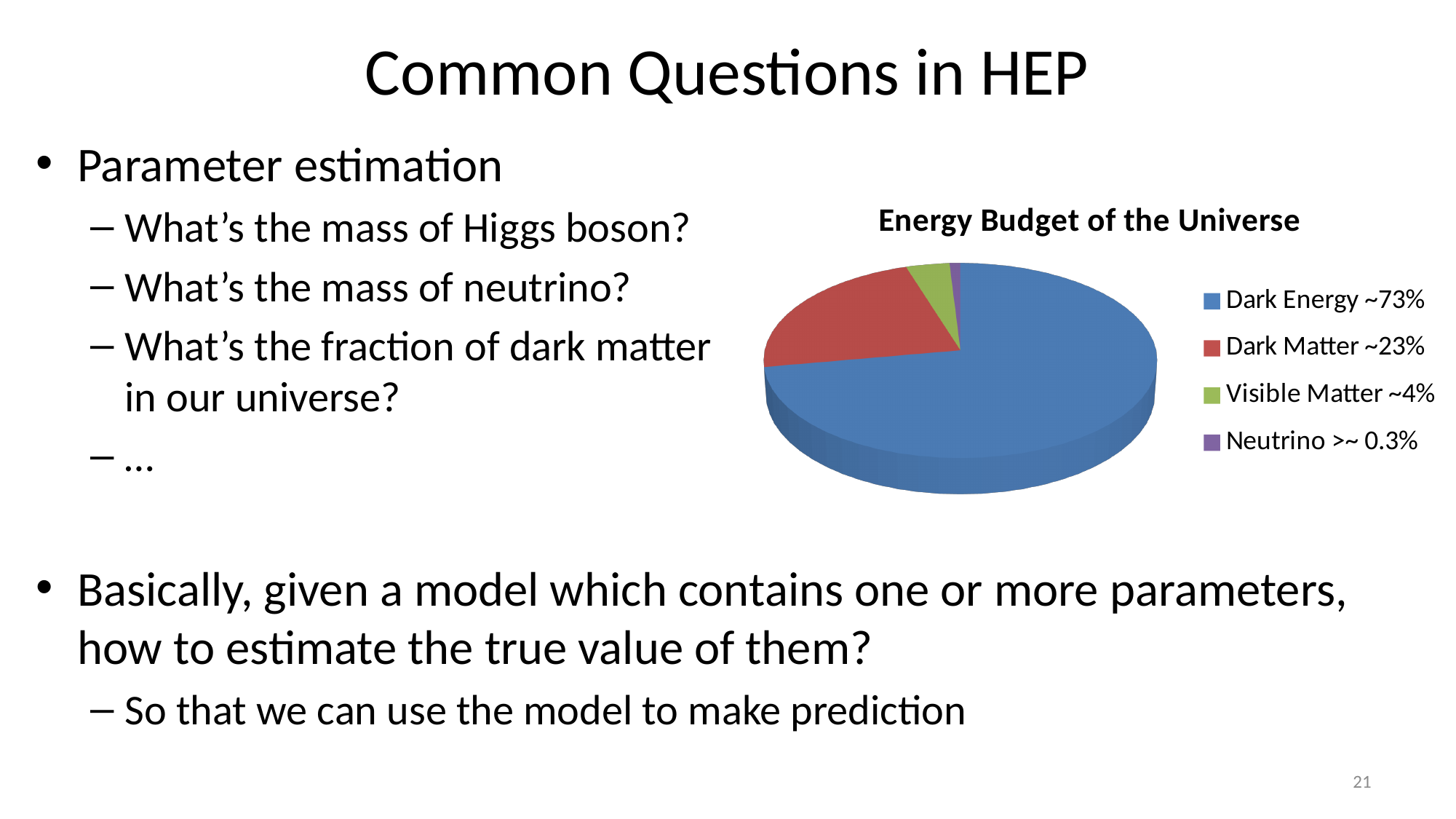
Which slice is larger, Dark Energy or Dark Matter? Dark Energy What share of the pie does the legend give for Dark Energy? ~73% What share of the pie does the legend give for Dark Matter? ~23% What share does the legend give for Neutrino? >~ 0.3% What colour is the Dark Matter slice in the pie chart? red Which slice is larger, Dark Matter or Visible Matter? Dark Matter Which category has the largest slice of the pie chart? Dark Energy Which category has the smallest slice of the pie chart? Neutrino How many slices (categories) does the pie chart have? 4 What kind of chart is shown on the slide? pie chart What is the title of the pie chart? Energy Budget of the Universe